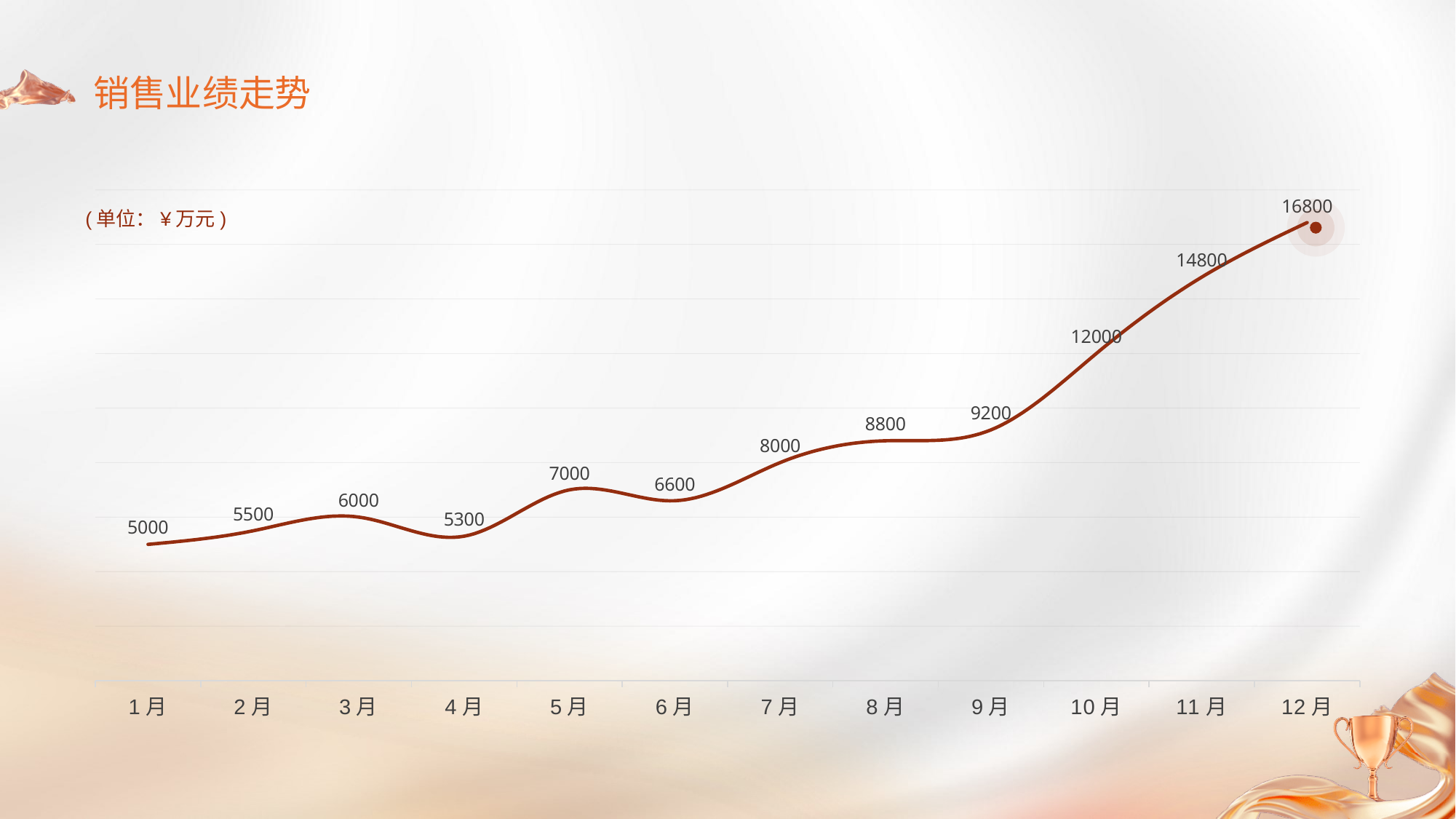
What is the difference between the values for 12月 and 11月? 2000 What is the value for 4月? 5300 Which month has the highest value? 12月 How many months are plotted on the x axis? 12 Which is larger, the value for 3月 or the value for 4月? 3月 Do the values generally rise or fall from 1月 to 12月? rise What is the value for 10月? 12000 What unit is stated for the chart values? ￥万元 What is the value for 5月? 7000 What kind of chart is shown on the slide? line chart What is the difference between the values for 9月 and 1月? 4200 Which month has the lowest value? 1月